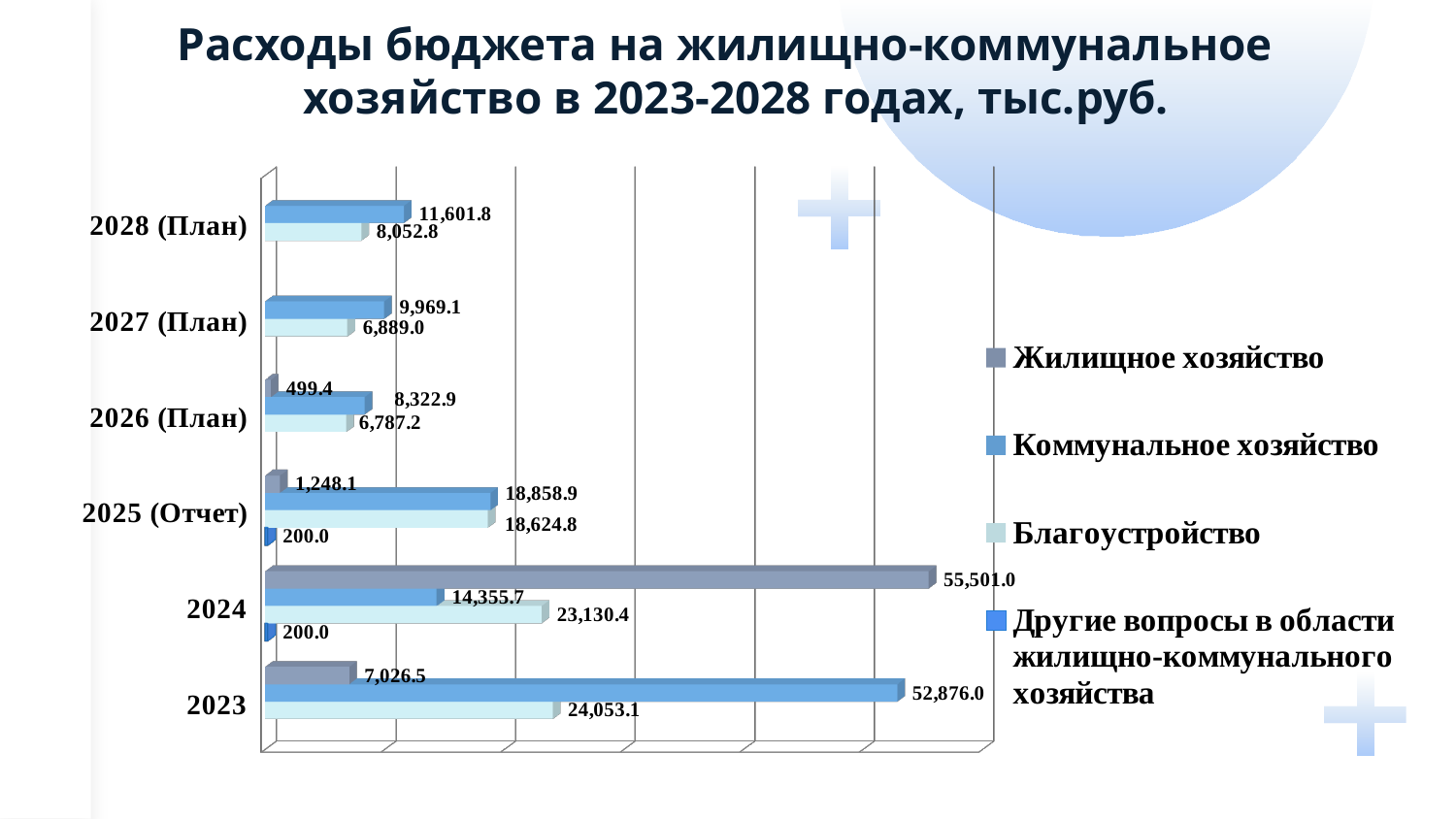
Does the value for Коммунальное хозяйство rise or fall from 2026 (План) to 2028 (План)? rise What is the value for Коммунальное хозяйство in 2023? 52,876.0 In which year is the value for Коммунальное хозяйство the highest? 2023 What is the value for Благоустройство in 2028 (План)? 8,052.8 How many year categories are shown on the chart? 6 In which year is the value for Благоустройство the lowest? 2026 (План) What type of chart is shown on the slide? bar chart What is the value for Другие вопросы в области жилищно-коммунального хозяйства in 2025 (Отчет)? 200.0 What is the difference between Коммунальное хозяйство and Благоустройство in 2027 (План)? 3,080.1 Which is larger in 2024: Коммунальное хозяйство or Благоустройство? Благоустройство What is the value for Жилищное хозяйство in 2024? 55,501.0 How many series does the legend list? 4